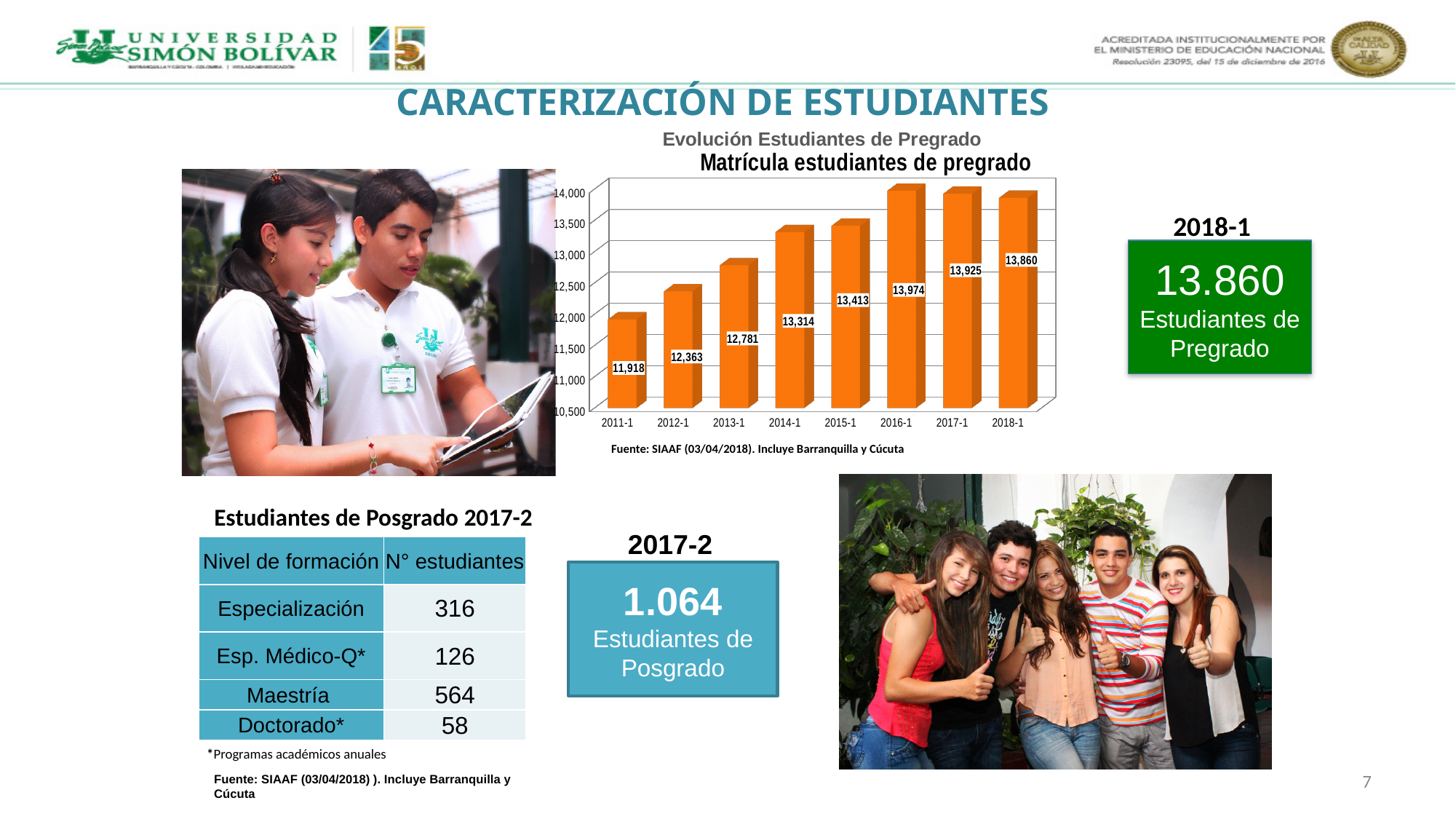
Which year has the highest value in the 'Matrícula estudiantes de pregrado' chart? 2016-1 What is the value for 2016-1 in the 'Matrícula estudiantes de pregrado' chart? 13,974 Which year has the lowest value in the 'Matrícula estudiantes de pregrado' chart? 2011-1 What kind of chart is 'Matrícula estudiantes de pregrado'? bar chart What is the value for 2011-1 in the 'Matrícula estudiantes de pregrado' chart? 11,918 In the 'Matrícula estudiantes de pregrado' chart, do the values rise or fall from 2011-1 to 2016-1? rise What is the difference between the values for 2018-1 and 2011-1 in the 'Matrícula estudiantes de pregrado' chart? 1,942 What is the value for 2018-1 in the 'Matrícula estudiantes de pregrado' chart? 13,860 In the 'Matrícula estudiantes de pregrado' chart, which is larger, the value for 2014-1 or the value for 2013-1? 2014-1 What is the difference between the values for 2016-1 and 2017-1 in the 'Matrícula estudiantes de pregrado' chart? 49 How many years are shown on the x axis of the 'Matrícula estudiantes de pregrado' chart? 8 In the 'Matrícula estudiantes de pregrado' chart, is the value for 2012-1 greater or less than 12,500? less